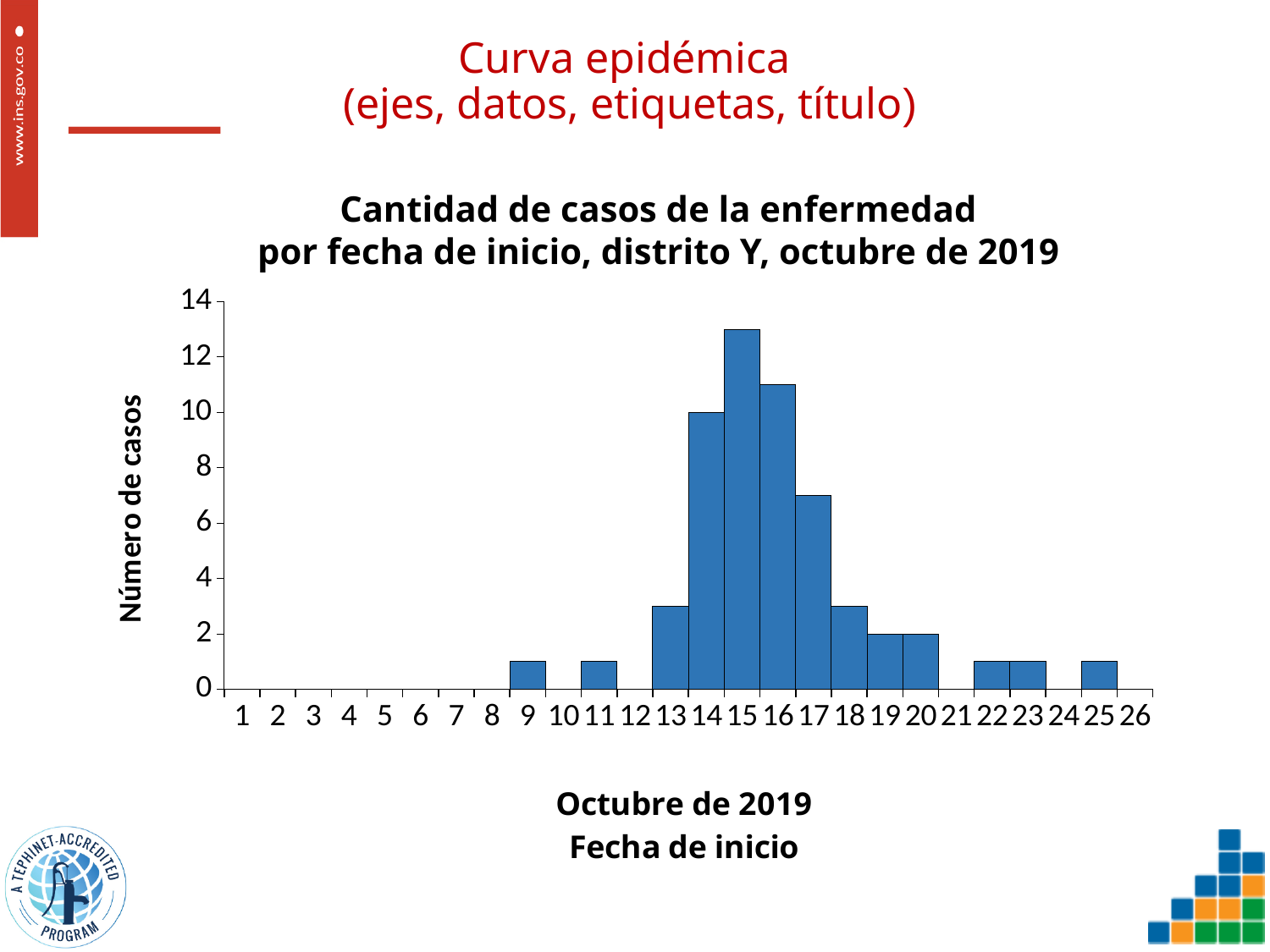
On which date of October 2019 is the number of cases highest? 15 Is the number of cases on October 17 greater or less than 8? less Is the number of cases on October 15 greater or less than 12? greater Is the number of cases on October 16 greater or less than 10? greater How many cases are shown for October 14? 10 How many cases are shown for October 20? 2 What kind of chart is shown on the slide? bar chart How many cases are shown for October 19? 2 How many dates are labelled along the x axis? 26 What is the label of the vertical axis? Número de casos What is the title of the chart? Cantidad de casos de la enfermedad por fecha de inicio, distrito Y, octubre de 2019 Which date has more cases, October 15 or October 17? October 15